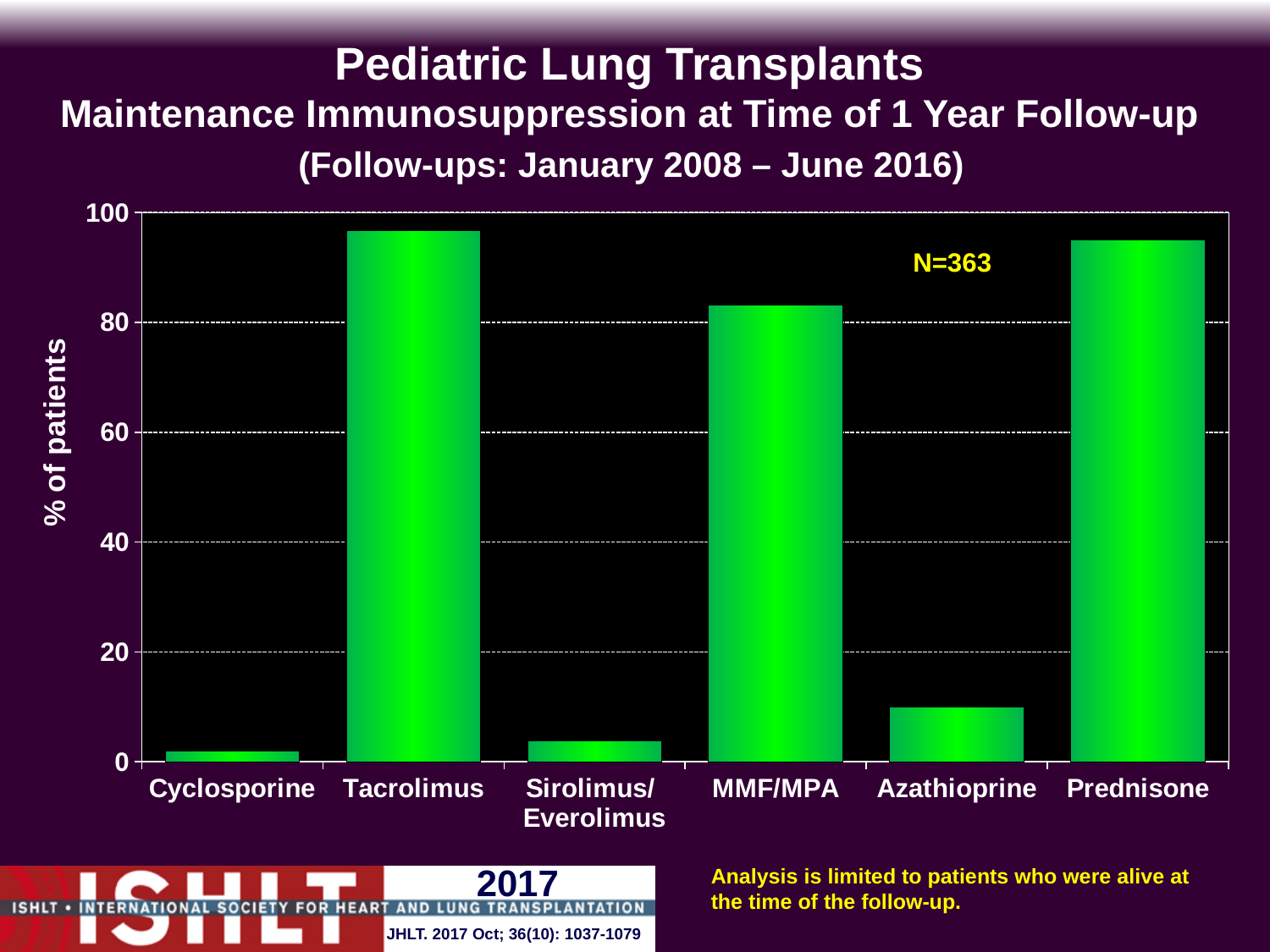
What kind of chart is shown on the slide? bar chart Is the value for Azathioprine greater or less than 20? less Which is larger, the value for Tacrolimus or the value for MMF/MPA? Tacrolimus How many immunosuppression categories are shown on the x axis? 6 What is the label on the y axis? % of patients Which is larger, the value for Azathioprine or the value for Cyclosporine? Azathioprine Is the value for MMF/MPA greater or less than 80? greater Is the value for Prednisone greater or less than 80? greater What sample size (N) is printed on the chart? N=363